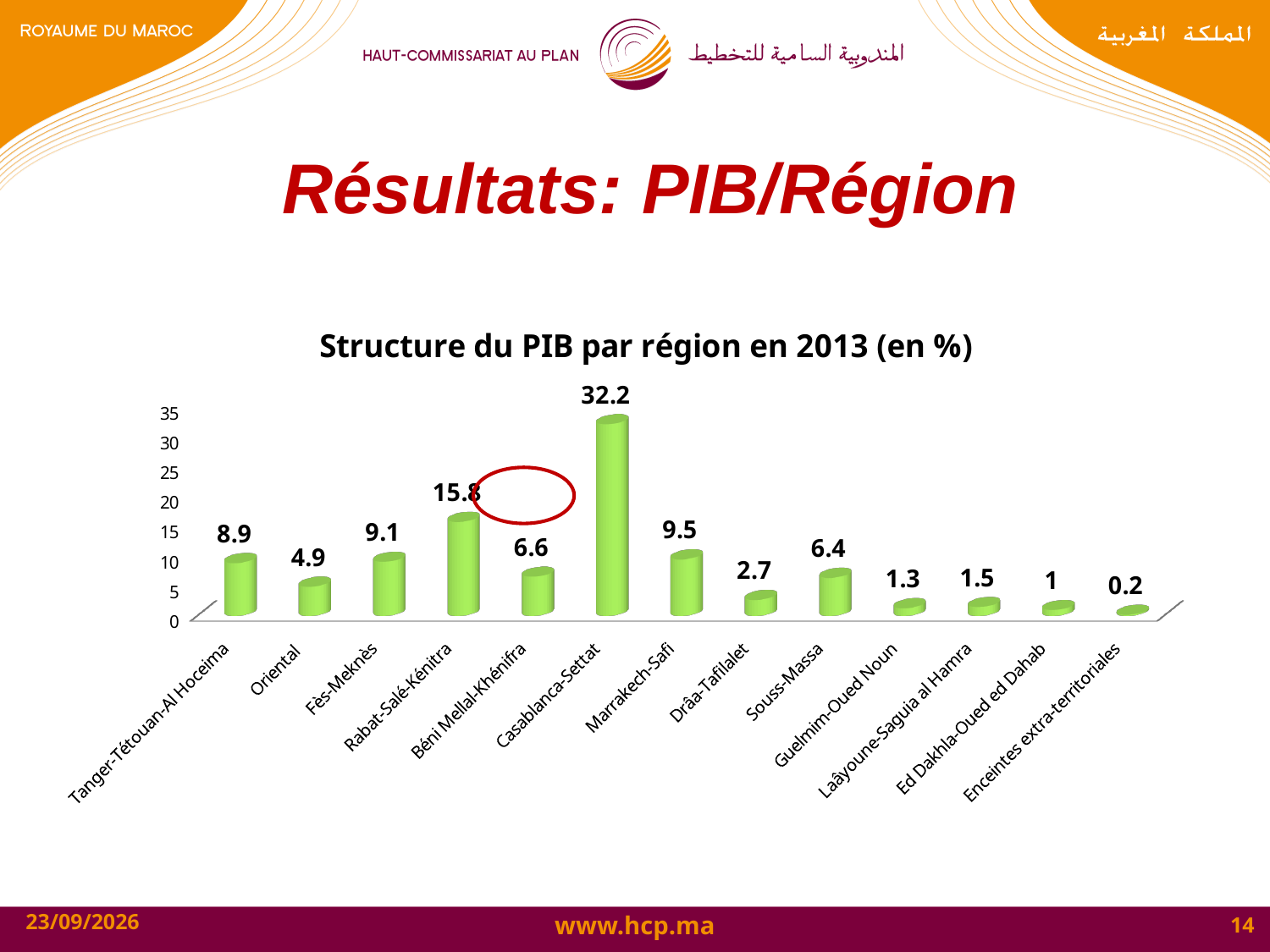
What is the value for Guelmim-Oued Noun? 1.3 What is the value for Marrakech-Safi? 9.5 Which region has the highest value? Casablanca-Settat Which category has the lowest value? Enceintes extra-territoriales What kind of chart is shown on the slide? bar chart How many categories are shown on the x axis? 13 What is the title of the chart? Structure du PIB par région en 2013 (en %) What is the value for Oriental? 4.9 What is the value for Casablanca-Settat? 32.2 Is the value for Casablanca-Settat greater or less than 30? greater What is the difference between the values for Casablanca-Settat and Marrakech-Safi? 22.7 Which is larger, the value for Fès-Meknès or the value for Tanger-Tétouan-Al Hoceima? Fès-Meknès